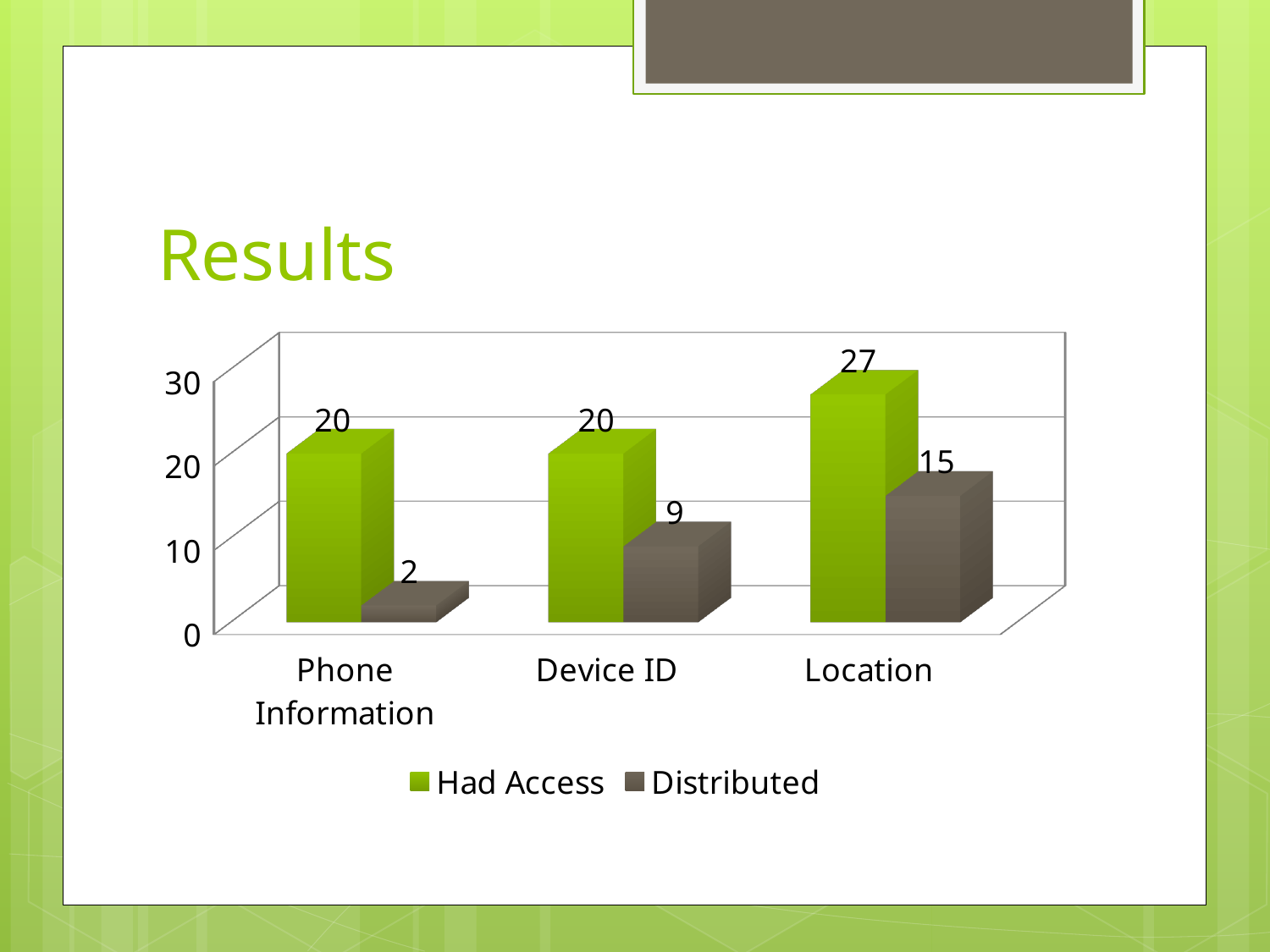
What is the Distributed value for Device ID? 9 How many series does the legend list? 2 Which is larger: the Distributed value for Device ID or the Distributed value for Location? Location What is the Distributed value for Phone Information? 2 What is the Had Access value for Location? 27 Which category has the highest Distributed value? Location What are the two series named in the legend? Had Access and Distributed What kind of chart is shown on the slide? Bar chart Which category has the lowest Distributed value? Phone Information How many categories are shown on the x axis? 3 What is the Had Access value for Device ID? 20 What is the difference between the Had Access and Distributed values for Location? 12